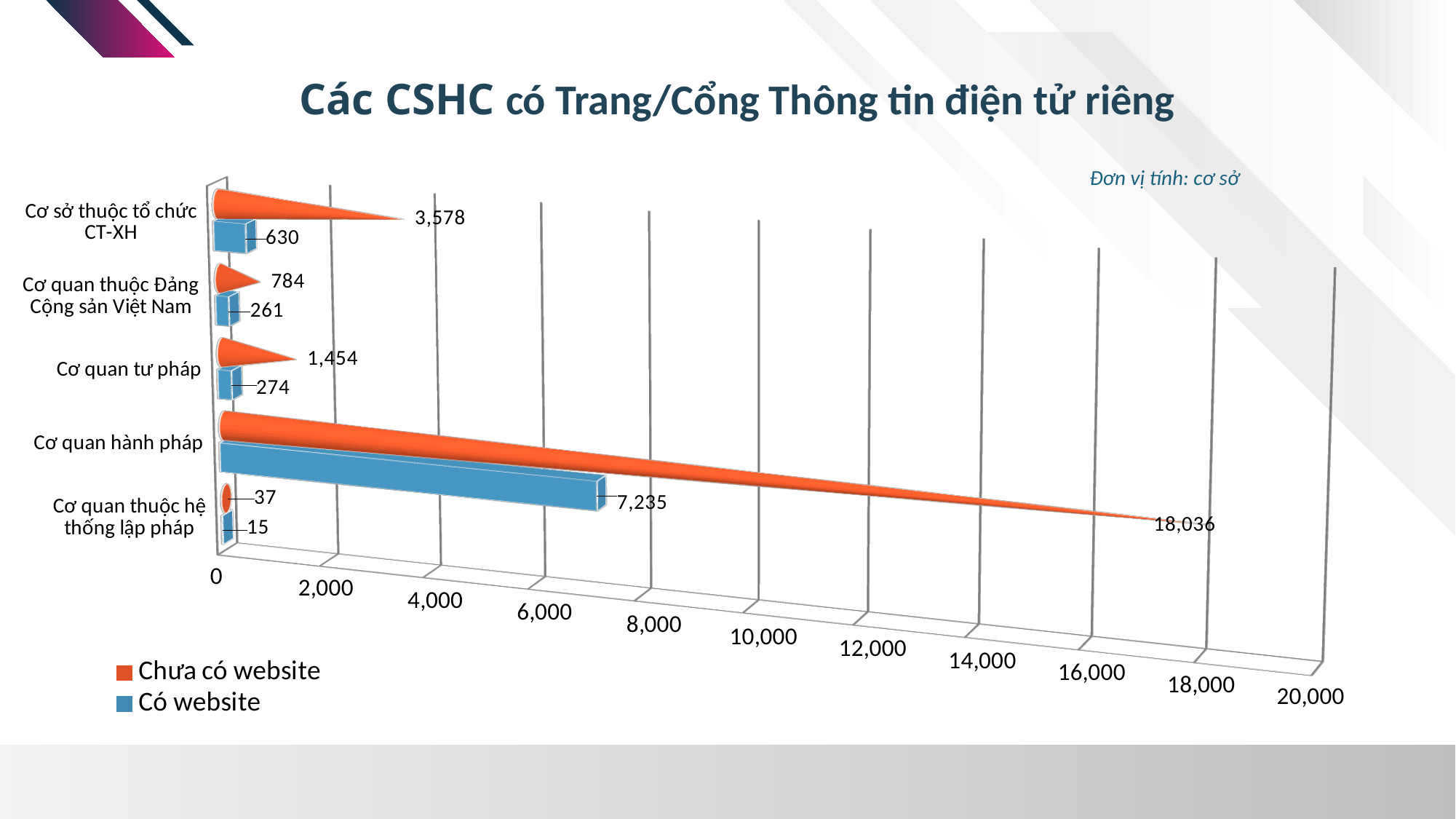
What is the value of "Chưa có website" for Cơ sở thuộc tổ chức CT-XH? 3,578 How many categories are shown on the chart? 5 What is the value of "Có website" for Cơ quan thuộc Đảng Cộng sản Việt Nam? 261 Which is larger: the "Chưa có website" value for Cơ quan tư pháp or for Cơ quan thuộc Đảng Cộng sản Việt Nam? Cơ quan tư pháp What is the value of "Có website" for Cơ quan hành pháp? 7,235 What is the difference between the "Chưa có website" and "Có website" values for Cơ quan tư pháp? 1,180 How many series does the legend list? 2 Which category has the highest "Chưa có website" value? Cơ quan hành pháp What is the value of "Có website" for Cơ quan thuộc hệ thống lập pháp? 15 What is the value of "Chưa có website" for Cơ quan hành pháp? 18,036 What type of chart is shown on the slide? Bar chart Which category has the lowest "Có website" value? Cơ quan thuộc hệ thống lập pháp